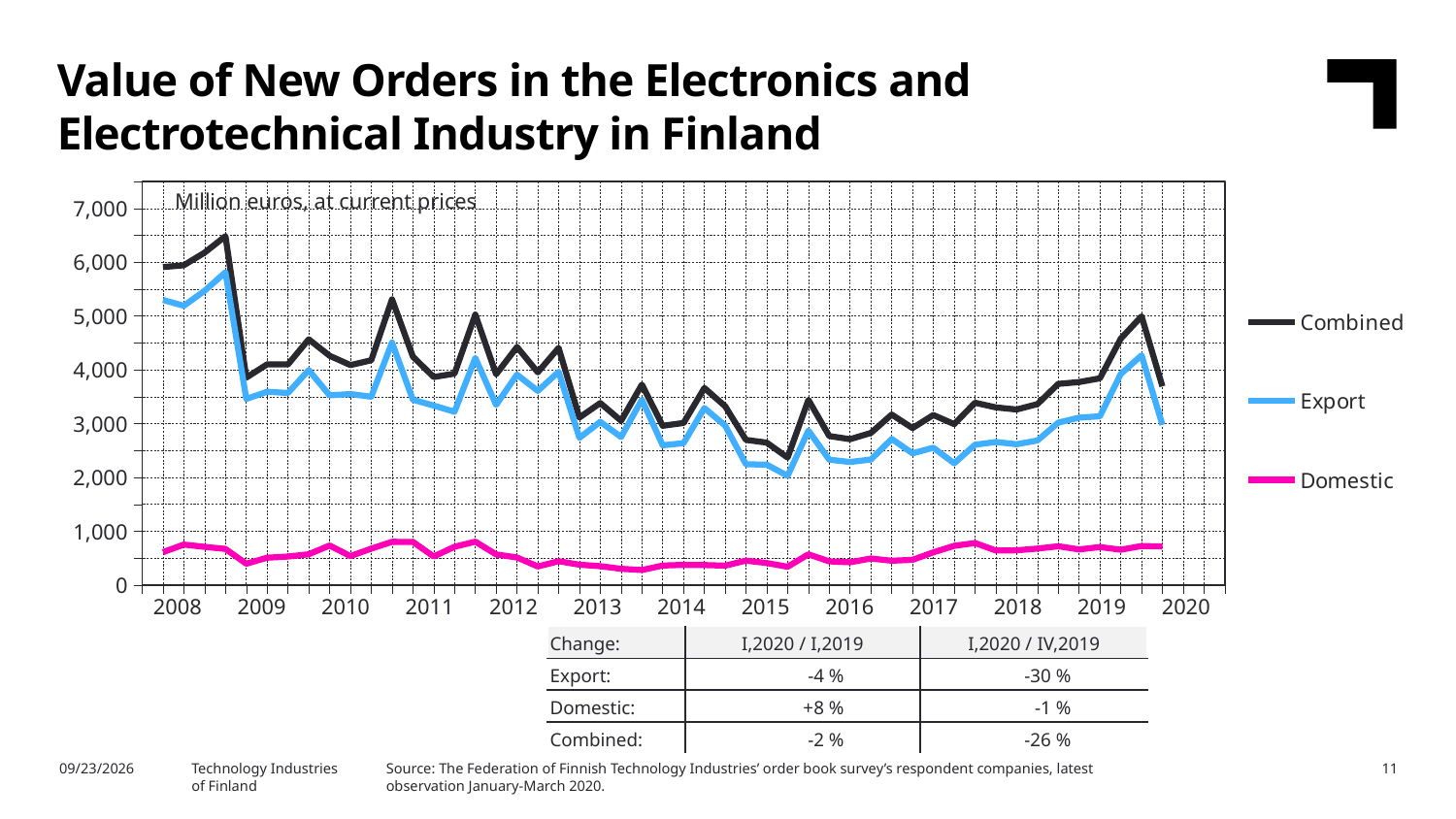
Which series are listed in the chart legend? Combined, Export, Domestic Which series has the lowest values throughout the chart? Domestic How many series does the legend list? 3 Is the value for Export in 2015 greater or less than 3,000? less What unit is stated in the chart's subtitle? Million euros, at current prices Which series has the highest values throughout the chart? Combined Is the Domestic series ever greater or less than 1,000 across the whole period? less Does the Combined series generally rise or fall from 2008 to 2016? fall Which is larger in 2019, the Export series or the Domestic series? Export What kind of chart is shown on the slide? Line chart Is the peak value of the Combined series in 2008 greater or less than 6,000? greater How many year labels are shown on the x axis? 13